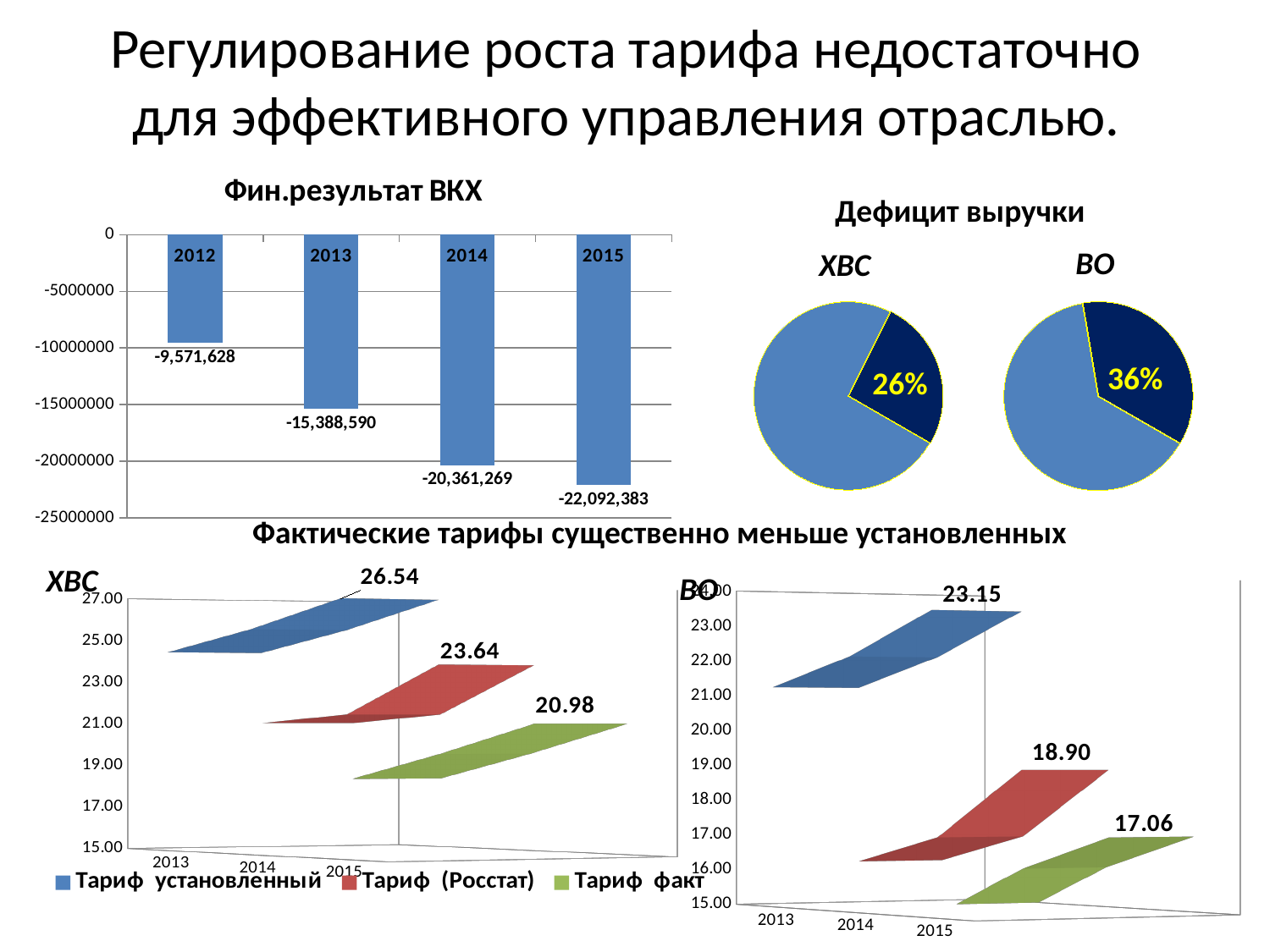
In the 'Дефицит выручки' pies, what share is labelled on the ХВС pie? 26% What kind of chart is 'Фин.результат ВКХ'? bar chart How many series does the legend of the bottom tariff charts list? 3 In the 'Фин.результат ВКХ' chart, which year has the lowest (most negative) value? 2015 In the 'Дефицит выручки' pies, which pie has the larger labelled slice, ХВС or ВО? ВО In the 'Фин.результат ВКХ' chart, what is the difference between the 2013 and 2012 values? 5,816,962 In the 'Фин.результат ВКХ' chart, what is the value for 2015? -22,092,383 In the bottom-right ВО tariff chart, what is the labelled value for 'Тариф факт'? 17.06 In the bottom-left ХВС tariff chart, what is the labelled value for 'Тариф установленный'? 26.54 In the 'Фин.результат ВКХ' chart, how many years are shown? 4 In the 'Фин.результат ВКХ' chart, do the values rise or fall from 2012 to 2015? fall In the 'Фин.результат ВКХ' chart, what is the value for 2012? -9,571,628